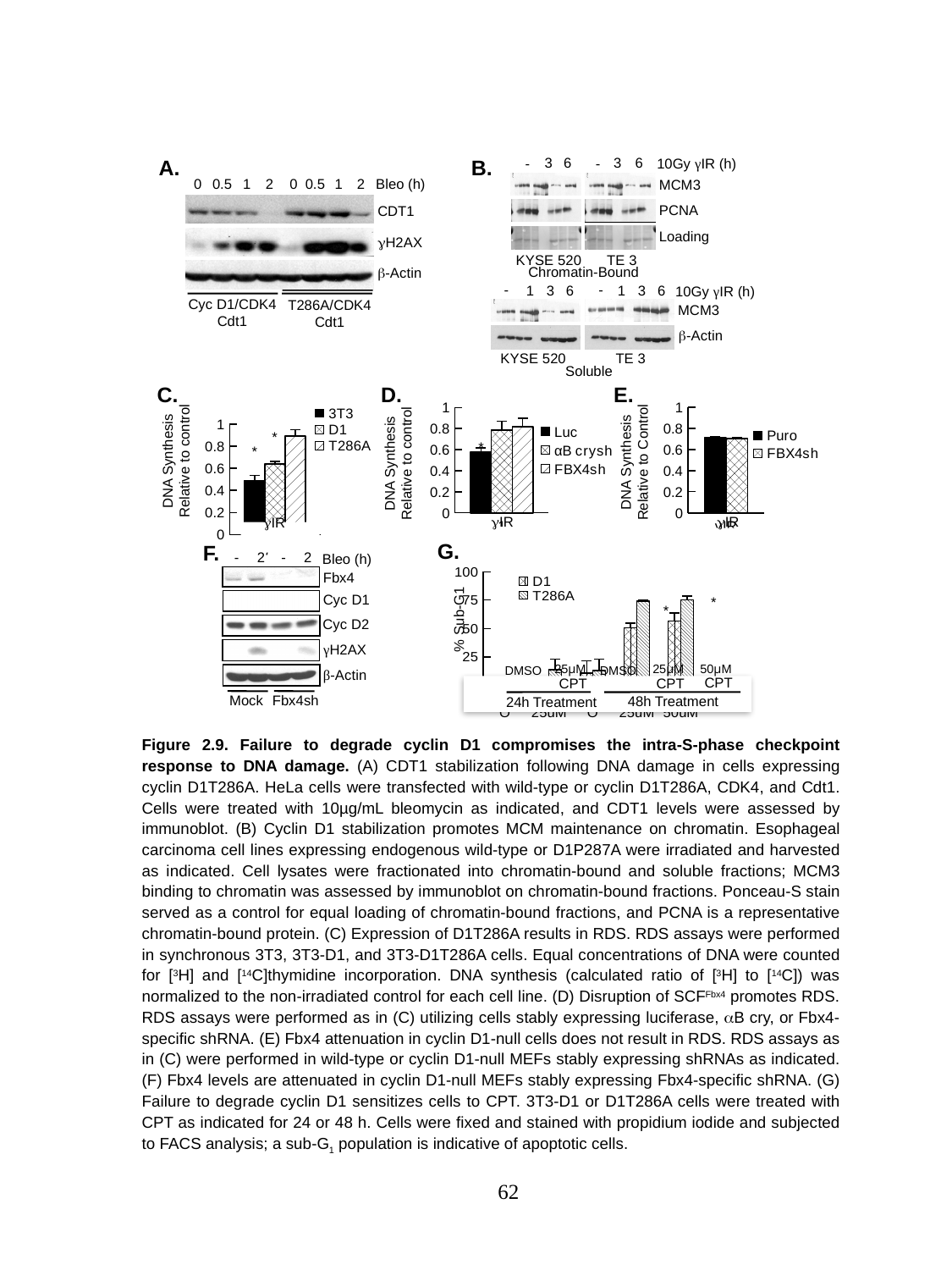
In chart D, is the value for Luc greater or less than 0.8? less In chart C, which cell line has the lowest DNA synthesis relative to control? 3T3 In chart D, which is larger, the value for FBX4sh or the value for Luc? FBX4sh What kind of chart is chart C? bar chart In chart D, how many series does the legend list? 3 In chart C, how many series does the legend list? 3 In chart D, which series has the lowest DNA synthesis relative to control? Luc In chart E, what are the two legend entries? Puro and FBX4sh In chart G, what is the label on the y axis? % Sub-G1 In chart C, is the value for 3T3 greater or less than 0.6? less In chart C, is the value for T286A greater or less than 0.8? greater In chart C, which cell line has the highest DNA synthesis relative to control? T286A